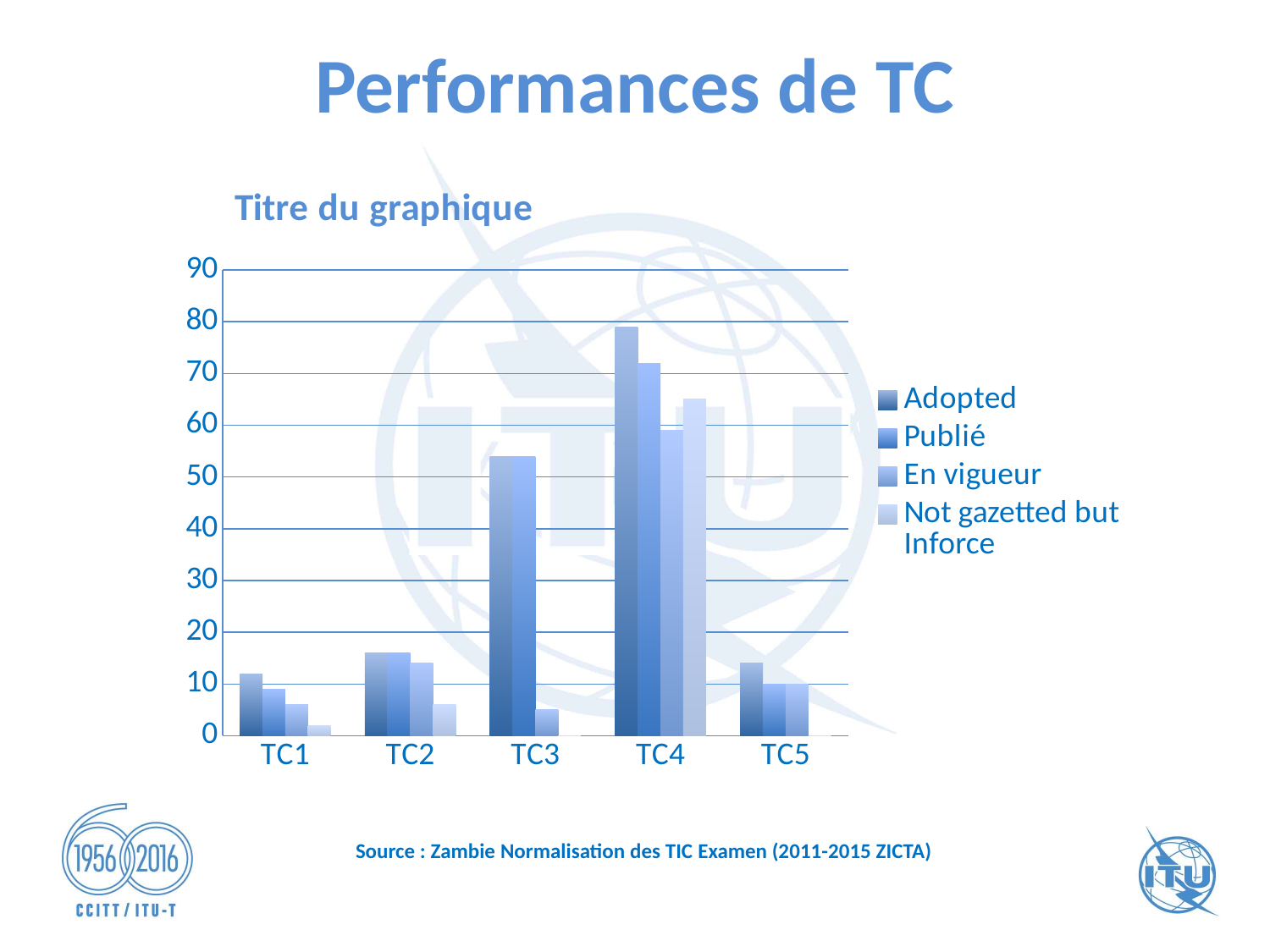
Which category has the larger Adopted value, TC2 or TC3? TC3 Is the Adopted value for TC4 greater or less than 70? greater How many categories are shown on the x axis? 5 Is the Adopted value for TC1 greater or less than 20? less Is the Not gazetted but Inforce value for TC4 greater or less than 60? greater How many series does the legend list? 4 Which is larger for TC4, the Adopted value or the Publié value? Adopted What kind of chart is shown on the slide? bar chart Which category has the highest Publié value? TC4 What is the title shown above the chart? Titre du graphique Which category has the highest Adopted value? TC4